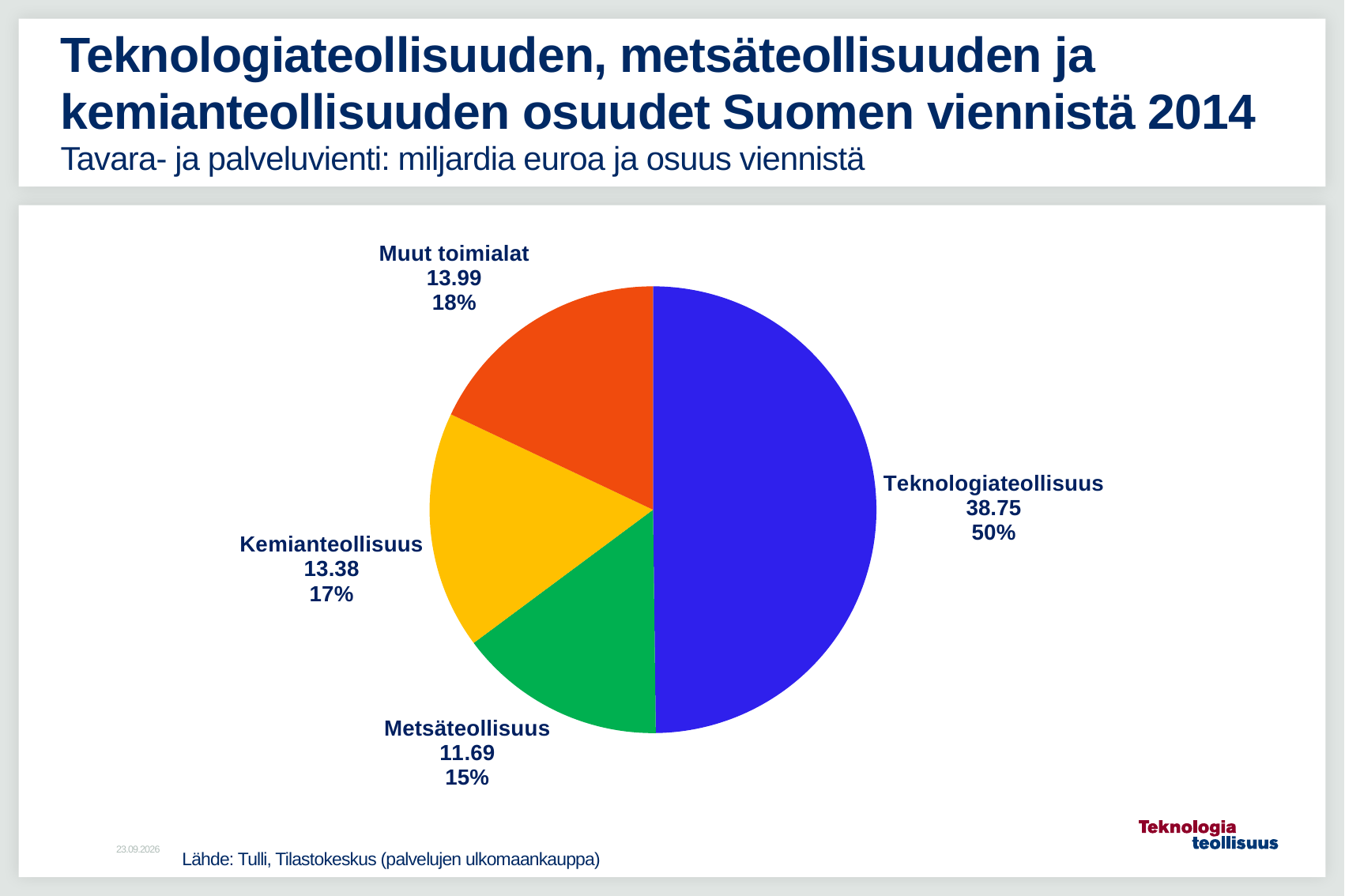
How many slices does the pie chart have? 4 Which has a larger value, Kemianteollisuus or Metsäteollisuus? Kemianteollisuus What is the difference between the values for Teknologiateollisuus and Metsäteollisuus? 27.06 What type of chart is shown on the slide? Pie chart What share of the pie does Metsäteollisuus have? 15% Which slice of the pie is the largest? Teknologiateollisuus What is the value shown for Kemianteollisuus? 13.38 What colour is the Teknologiateollisuus slice? Blue What share of the pie does Muut toimialat have? 18% What is the difference between the values for Muut toimialat and Kemianteollisuus? 0.61 Which slice of the pie is the smallest? Metsäteollisuus What is the value shown for Teknologiateollisuus? 38.75